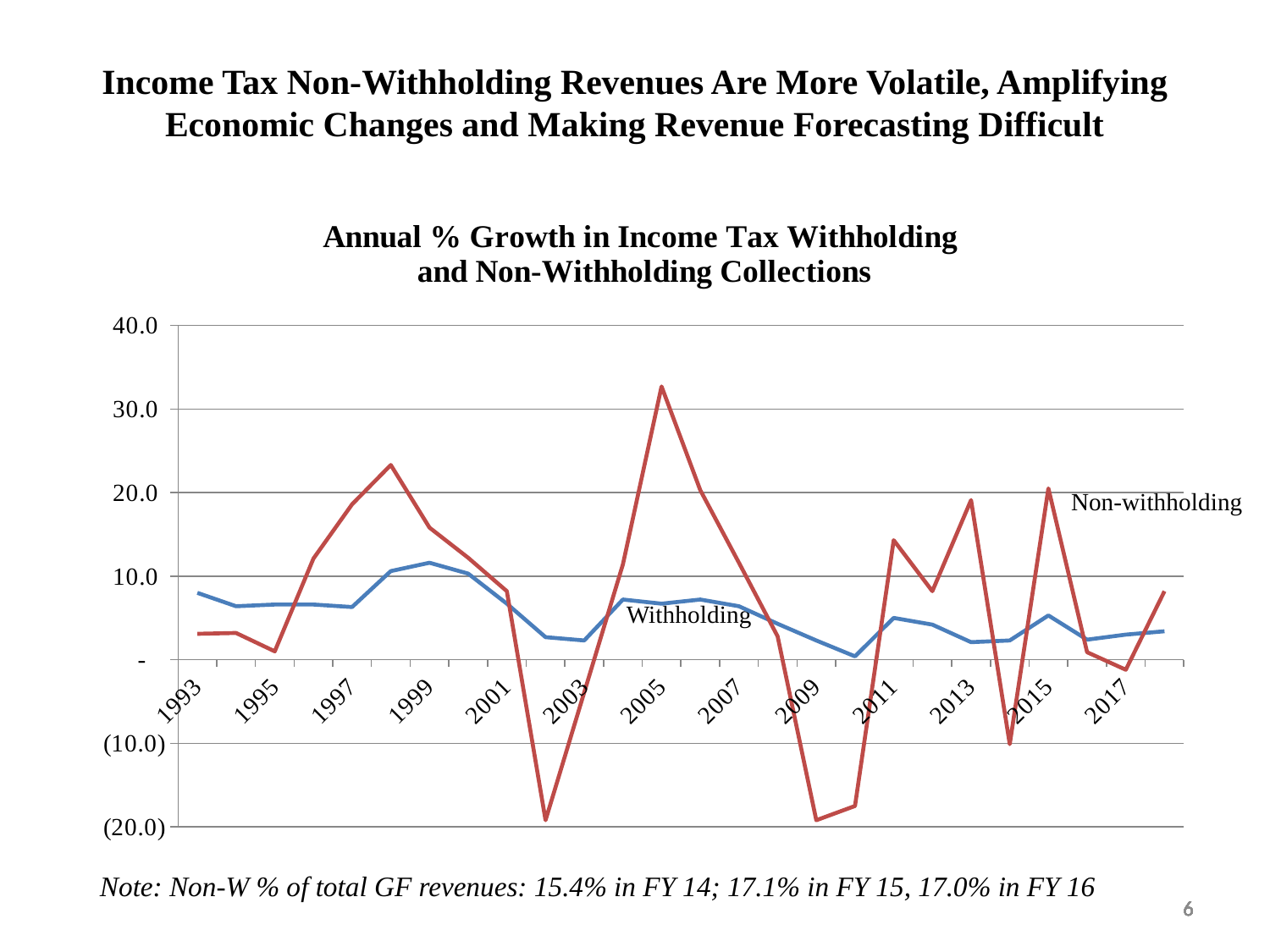
How many data series are plotted in the chart? 2 Which series is drawn in red? Non-withholding Which series reaches the highest value anywhere on the chart? Non-withholding In which year does the Non-withholding series reach its highest value? 2005 In 2005, which series has the larger value, Withholding or Non-withholding? Non-withholding Is the Withholding value for 2010 greater or less than 10.0? less Is the Non-withholding value for 1998 greater or less than 20.0? greater Is the Non-withholding value for 2005 greater or less than 30.0? greater What type of chart is shown on the slide? Line chart What is the title of the chart? Annual % Growth in Income Tax Withholding and Non-Withholding Collections Does the Withholding series rise or fall between 1999 and 2002? Fall